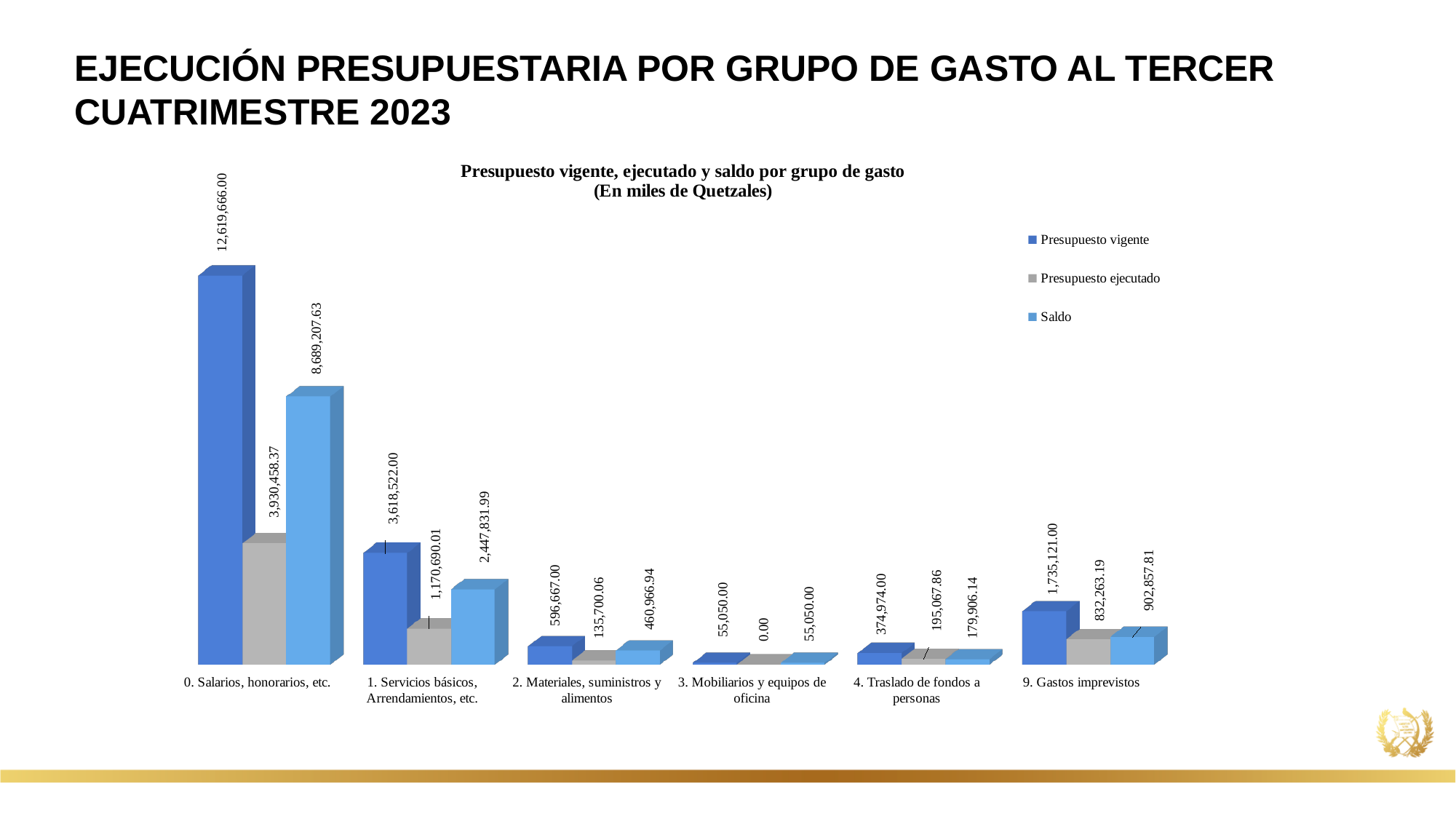
Which category has the lowest Presupuesto vigente? 3. Mobiliarios y equipos de oficina For '4. Traslado de fondos a personas', which is larger: Presupuesto ejecutado or Saldo? Presupuesto ejecutado What is the Presupuesto vigente value for '0. Salarios, honorarios, etc.'? 12,619,666.00 How many series does the legend list? 3 What is the title of the chart? Presupuesto vigente, ejecutado y saldo por grupo de gasto (En miles de Quetzales) What is the difference between the Presupuesto vigente and the Presupuesto ejecutado for '0. Salarios, honorarios, etc.'? 8,689,207.63 What is the Presupuesto ejecutado value for '1. Servicios básicos, Arrendamientos, etc.'? 1,170,690.01 What type of chart is shown on the slide? Bar chart What is the Presupuesto ejecutado value for '3. Mobiliarios y equipos de oficina'? 0.00 What is the Saldo value for '2. Materiales, suministros y alimentos'? 460,966.94 How many expense groups (categories) are shown on the x axis? 6 Which category has the highest Presupuesto vigente? 0. Salarios, honorarios, etc.